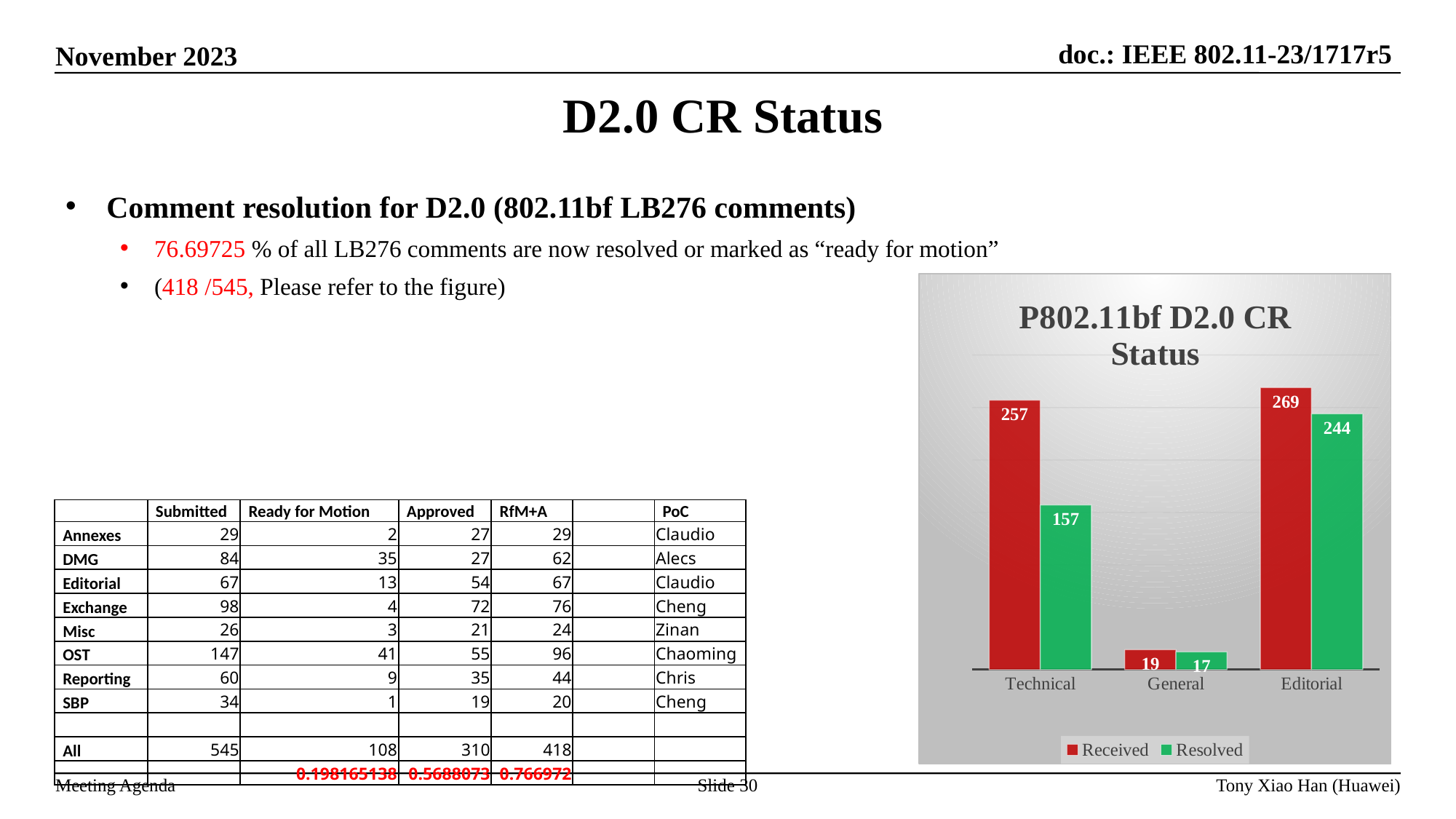
How many categories are shown on the x axis? 3 Which category has the lowest Resolved value? General What is the difference between Received and Resolved for Editorial? 25 What is the Resolved value for Editorial? 244 How many series does the legend list? 2 What is the title of the chart? P802.11bf D2.0 CR Status What kind of chart is shown? bar chart Which category has the highest Received value? Editorial What is the difference between Received and Resolved for Technical? 100 What is the Received value for Technical? 257 What is the Resolved value for General? 17 Which is larger, the Resolved value for Technical or the Resolved value for Editorial? Editorial